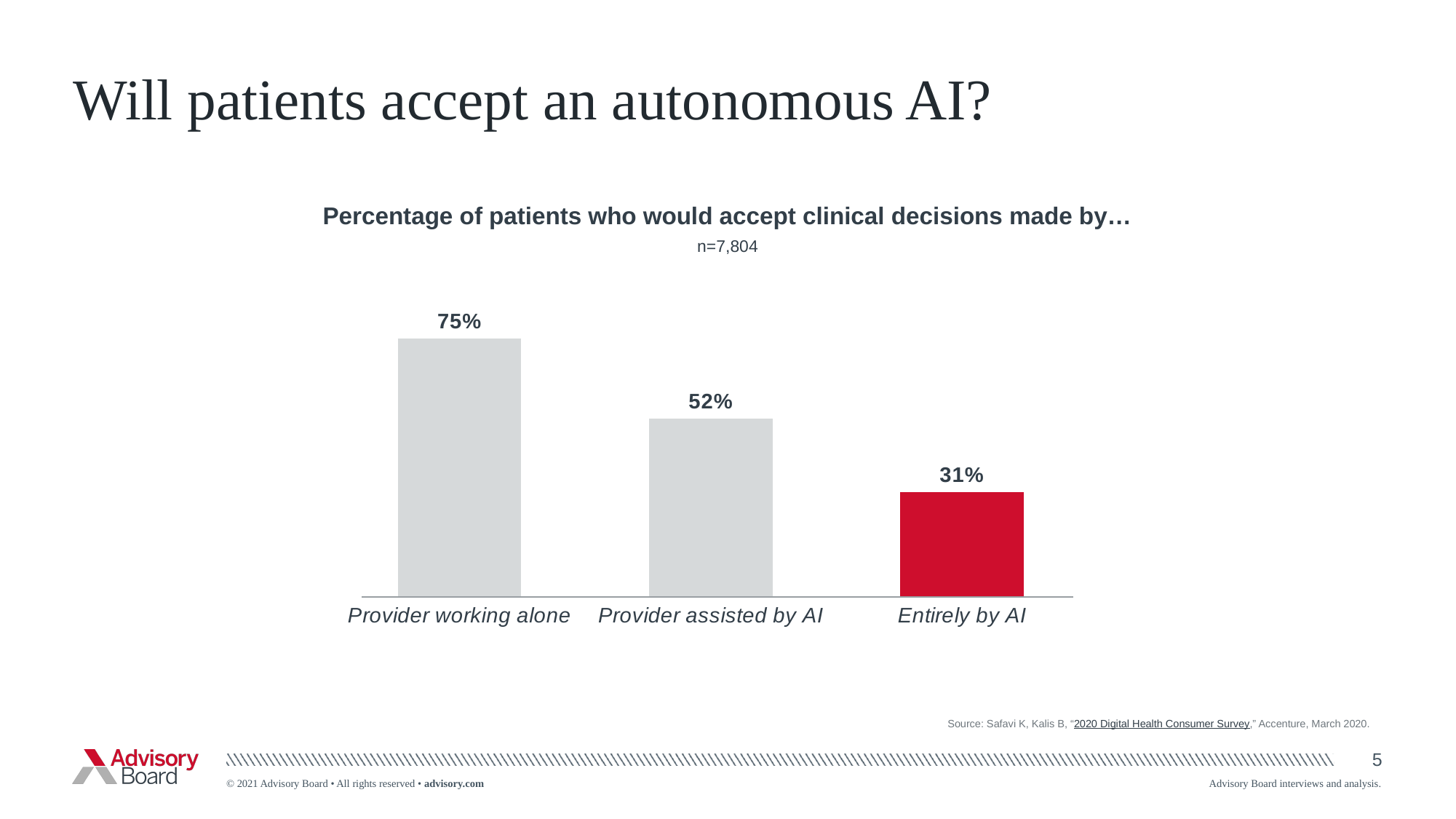
What percentage of patients would accept clinical decisions made by a provider assisted by AI? 52% Which category has the highest percentage of patients accepting clinical decisions? Provider working alone What is the sample size (n) shown under the chart title? n=7,804 Which category has the lowest percentage of patients accepting clinical decisions? Entirely by AI Do the values rise or fall from left to right across the categories? Fall What percentage of patients would accept clinical decisions made entirely by AI? 31% How many categories are shown in the chart? 3 What percentage of patients would accept clinical decisions made by a provider working alone? 75% What is the difference in percentage points between 'Provider working alone' and 'Entirely by AI'? 44 percentage points Which is larger: the percentage for 'Provider assisted by AI' or for 'Entirely by AI'? Provider assisted by AI What kind of chart is shown on the slide? Bar chart What is the difference in percentage points between 'Provider working alone' and 'Provider assisted by AI'? 23 percentage points